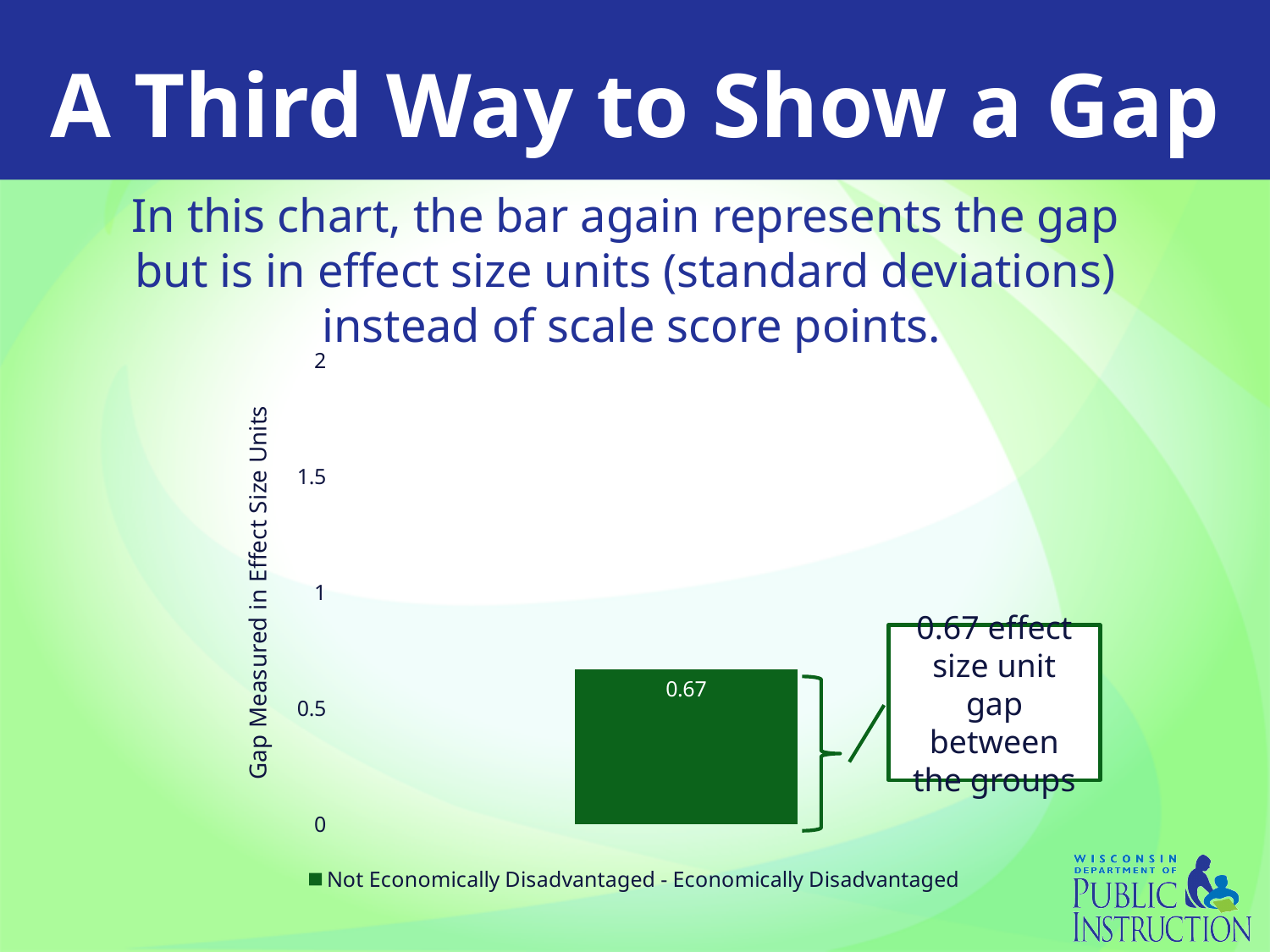
What kind of chart is shown on the slide? bar chart Is the value of the bar greater or less than 1? less How many series does the legend list? 1 How many bars are plotted in the chart? 1 What is the title of the vertical axis? Gap Measured in Effect Size Units What is the value of the bar labelled in the chart? 0.67 Is the value of the bar greater or less than 0.5? greater What is the maximum value shown on the vertical axis? 2 What is the label of the series in the legend? Not Economically Disadvantaged - Economically Disadvantaged